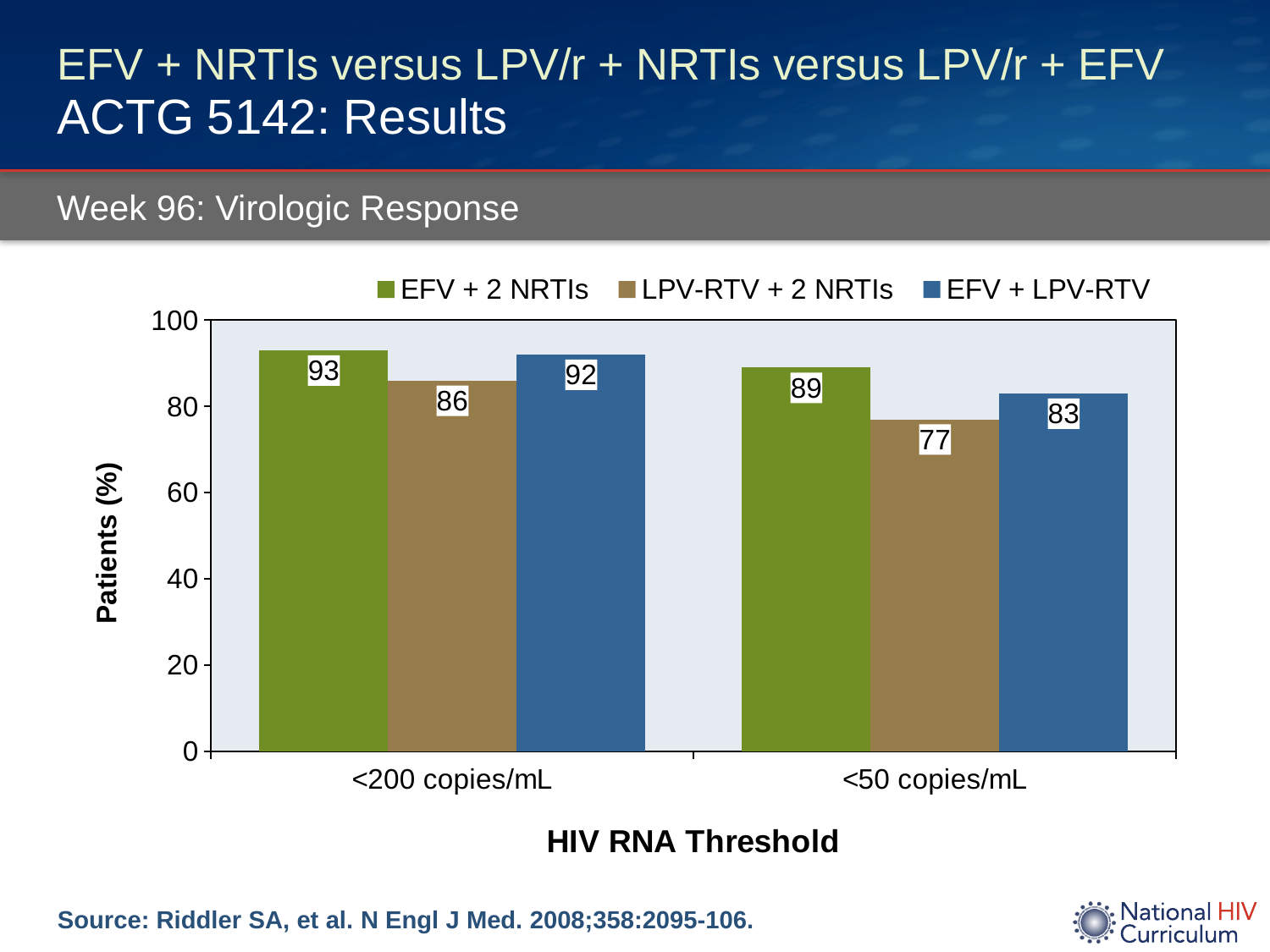
What kind of chart is shown on the slide? Bar chart How many series does the legend list? 3 What percentage of patients in the LPV-RTV + 2 NRTIs group had HIV RNA <50 copies/mL? 77 What is the difference between the EFV + 2 NRTIs and LPV-RTV + 2 NRTIs values at the <50 copies/mL threshold? 12 Which treatment group has the lowest value at the <50 copies/mL threshold? LPV-RTV + 2 NRTIs How many HIV RNA threshold categories are shown on the x axis? 2 Does the value for EFV + LPV-RTV fall or rise from the <200 copies/mL threshold to the <50 copies/mL threshold? Fall Which treatment group has the highest value at the <200 copies/mL threshold? EFV + 2 NRTIs What is the label of the y axis? Patients (%) What percentage of patients in the EFV + 2 NRTIs group had HIV RNA <200 copies/mL? 93 What is the value for EFV + LPV-RTV at the <200 copies/mL threshold? 92 Which is larger at the <200 copies/mL threshold: the LPV-RTV + 2 NRTIs value or the EFV + LPV-RTV value? EFV + LPV-RTV